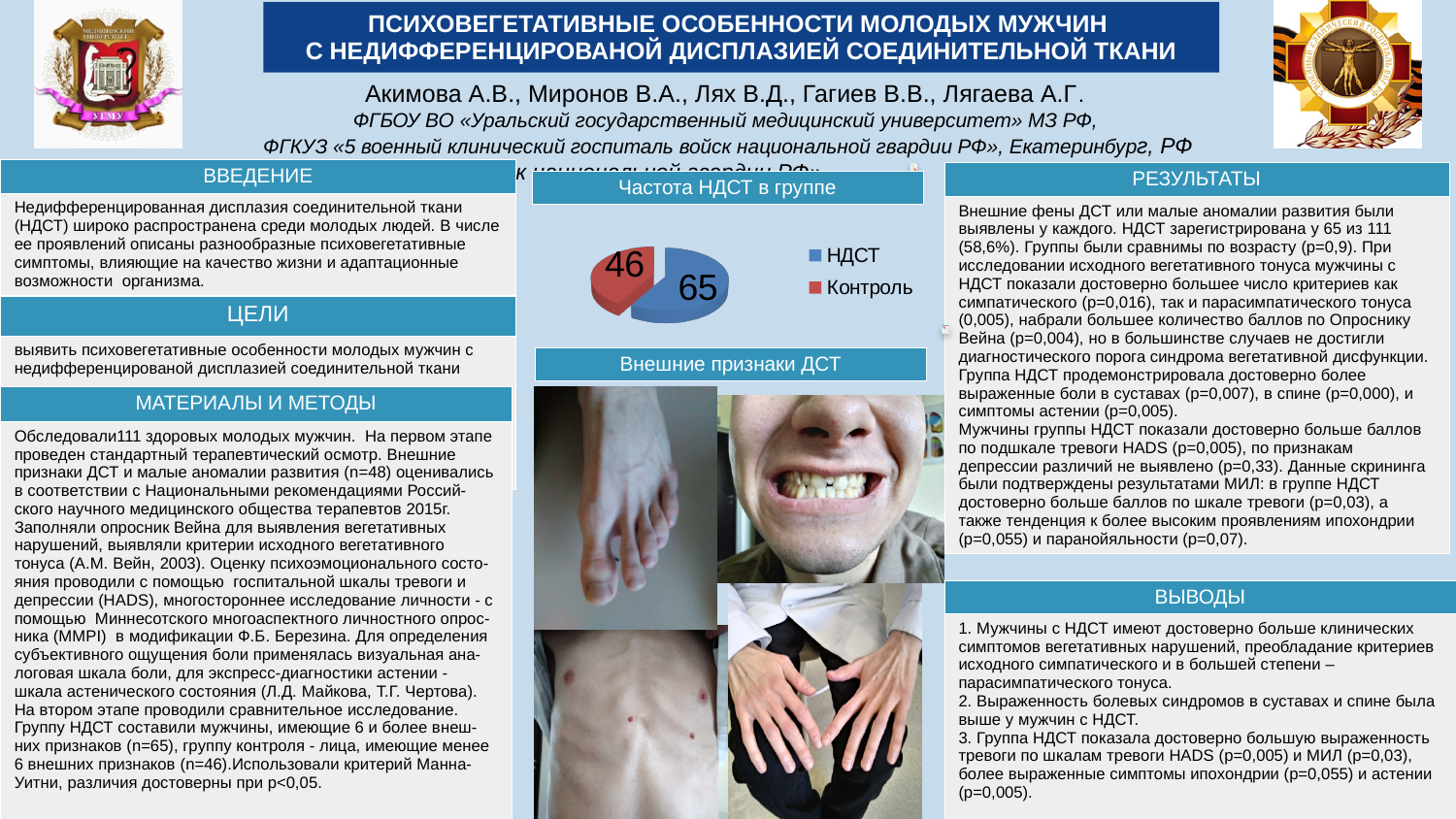
What type of chart is shown under the title "Частота НДСТ в группе"? pie chart How many slices does the pie chart have? 2 What is the title of the pie chart? Частота НДСТ в группе What is the total of the two values shown in the pie chart? 111 Which category has the smaller slice in the pie chart? Контроль What is the difference between the НДСТ and Контроль values in the pie chart? 19 Which category has the larger slice in the pie chart? НДСТ Is the value for НДСТ larger or smaller than the value for Контроль in the pie chart? larger What is the value for НДСТ in the pie chart? 65 What is the value for Контроль in the pie chart? 46 What colour is the НДСТ slice in the pie chart? blue How many entries does the legend of the pie chart list? 2